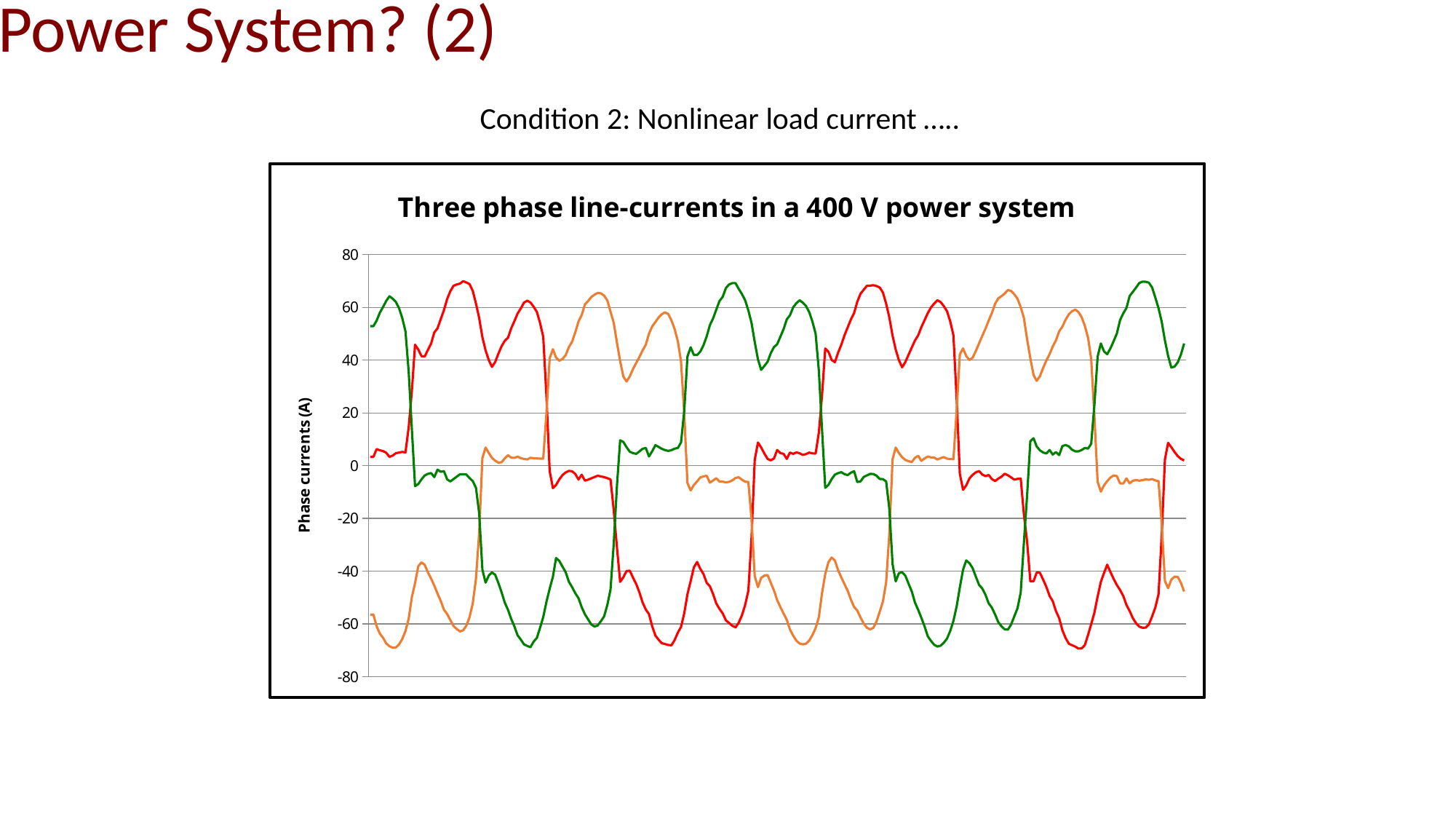
Is the highest peak of the red line greater or less than 60? greater What kind of chart is shown on the slide? Line chart Is the lowest trough of the orange line greater or less than -60? less Is the highest peak of the green line greater or less than 80? less What is the title of the chart? Three phase line-currents in a 400 V power system What is the highest value shown on the vertical axis? 80 How many line series are plotted on the chart? 3 What is the spacing between consecutive tick marks on the vertical axis? 20 What is the lowest value shown on the vertical axis? -80 What is the label on the vertical axis of the chart? Phase currents (A)